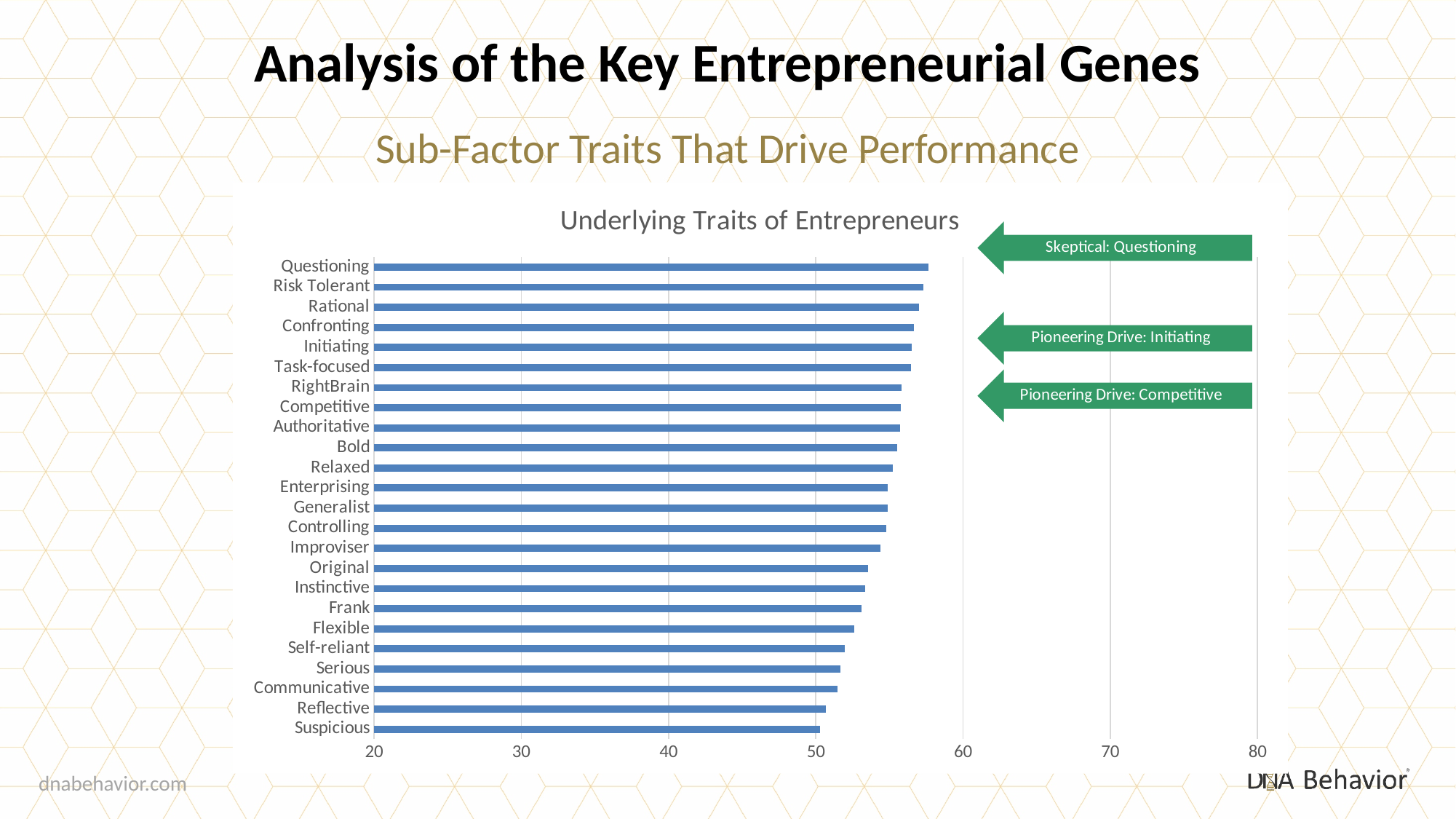
What is the highest value shown on the horizontal axis? 80 What is the title of the chart? Underlying Traits of Entrepreneurs Is the value for Suspicious greater or less than 60? less Which trait has the highest value in the chart? Questioning Is the value for Questioning greater or less than 50? greater How many traits (categories) are plotted in the chart? 24 Which has the larger value, Bold or Flexible? Bold What type of chart is shown on the slide? bar chart Which has the larger value, Frank or Serious? Frank Do the bar lengths increase or decrease going from the top trait to the bottom trait? decrease Which has the larger value, Questioning or Reflective? Questioning Which trait has the lowest value in the chart? Suspicious